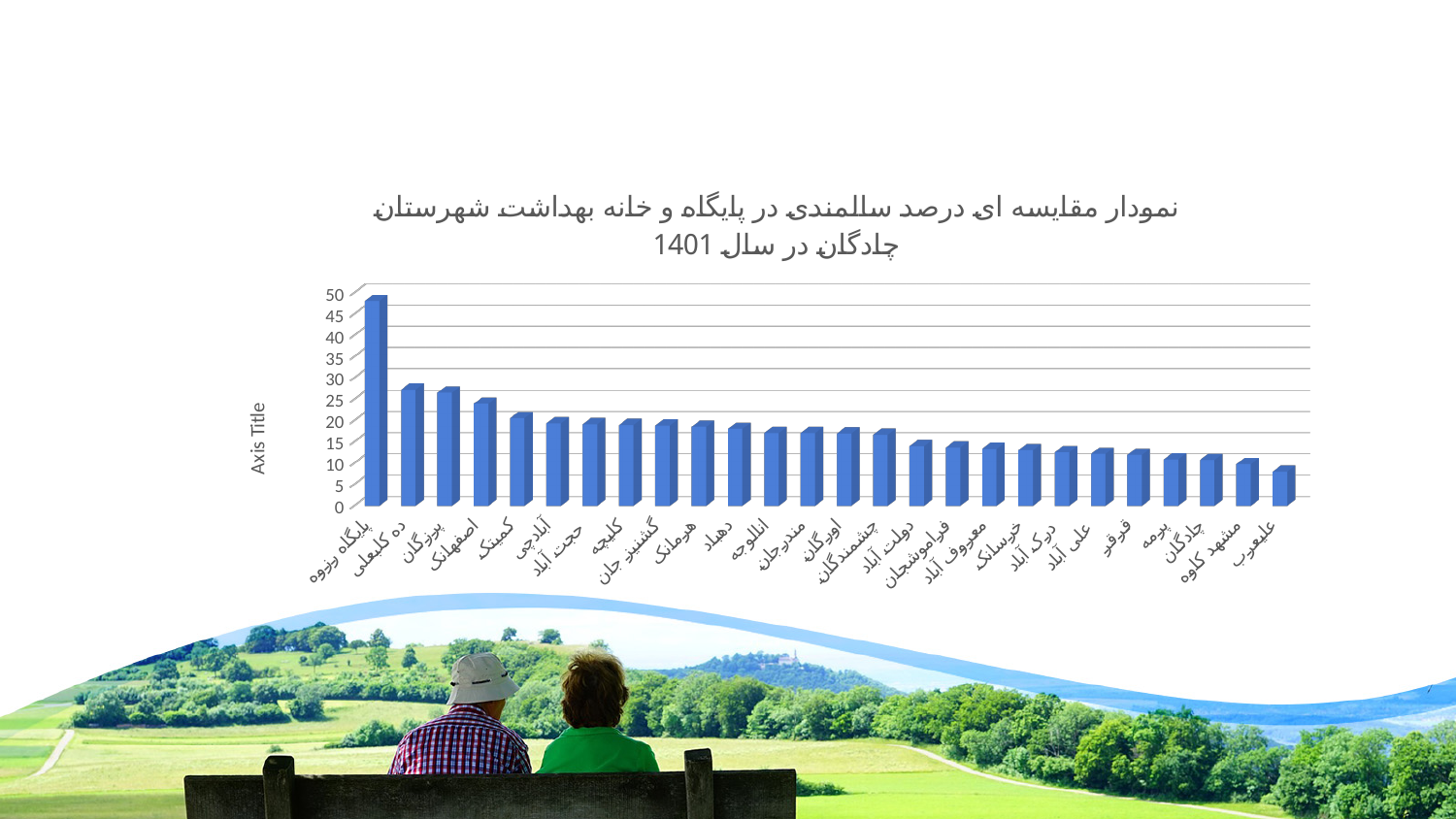
What year is mentioned in the chart title? 1401 Which has a larger value, پایگاه رزوه or ده کلبعلی? پایگاه رزوه Which category has the lowest value in the chart? علیعرب Is the value for چادگان greater or less than 15? less What kind of chart is shown on the slide? Bar chart Which has a larger value, پرزگان or علیعرب? پرزگان Is the value for ده کلبعلی greater or less than 20? greater Is the value for علیعرب greater or less than 15? less Do the bar values generally rise or fall from left to right along the x axis? Fall How many categories (bars) are plotted in the chart? 26 Which category has the highest value in the chart? پایگاه رزوه